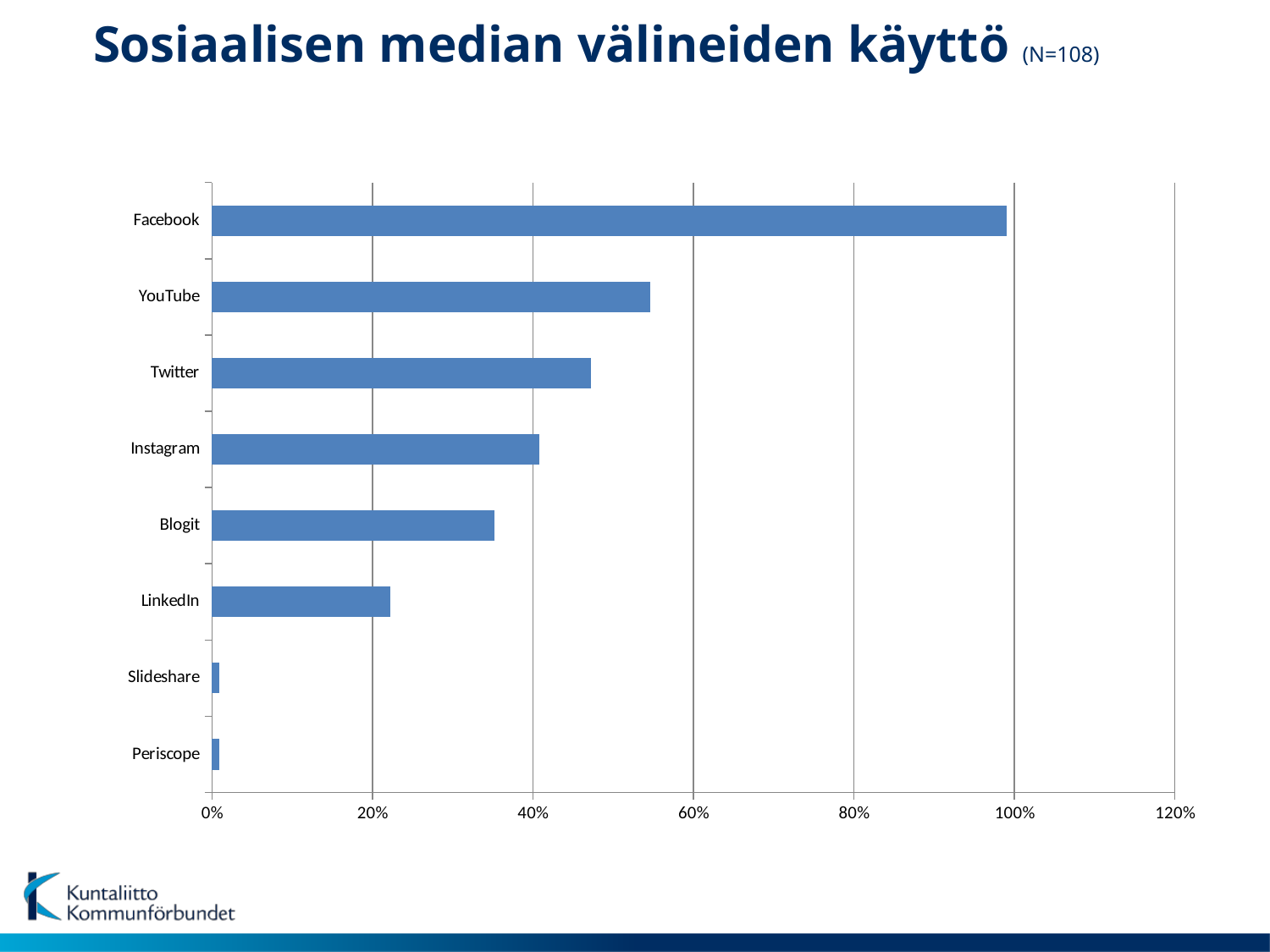
Which is larger, the value for YouTube or the value for Twitter? YouTube Is the value for LinkedIn greater or less than 20%? greater Is the value for Facebook greater or less than 80%? greater Is the value for Slideshare greater or less than 20%? less What is the title of the chart on the slide? Sosiaalisen median välineiden käyttö (N=108) Which is larger, the value for Instagram or the value for LinkedIn? Instagram Which category has the highest value? Facebook How many categories are plotted in the chart? 8 What kind of chart is shown on the slide? bar chart